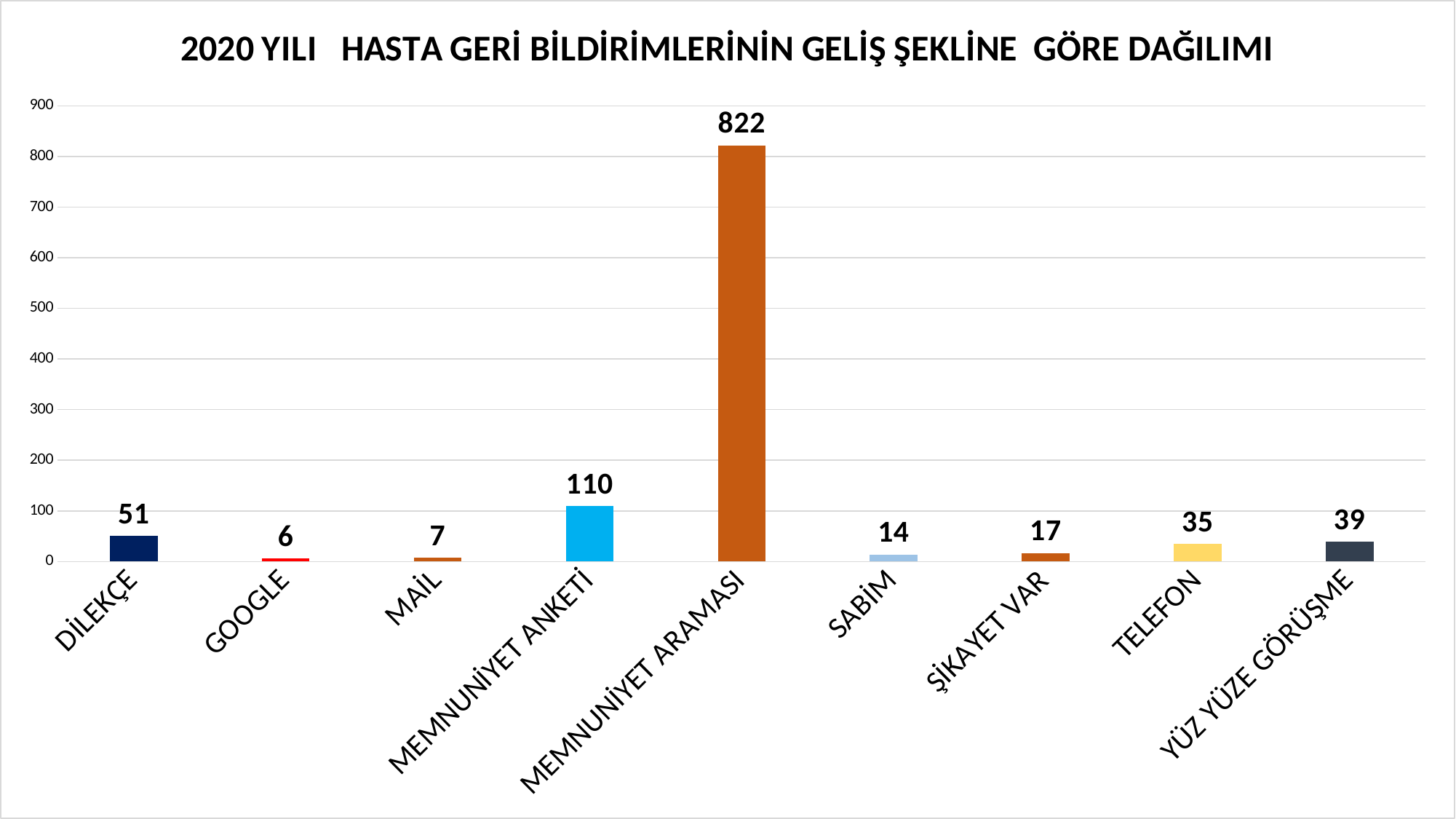
What kind of chart is shown on the slide? bar chart What is the value for SABİM? 14 Which category has the lowest value? GOOGLE What is the difference between the values for MEMNUNİYET ARAMASI and MEMNUNİYET ANKETİ? 712 How many categories are shown on the x axis? 9 What is the value for MEMNUNİYET ARAMASI? 822 Which is larger, the value for DİLEKÇE or the value for ŞİKAYET VAR? DİLEKÇE Which category has the highest value? MEMNUNİYET ARAMASI What is the value for TELEFON? 35 What is the difference between the values for YÜZ YÜZE GÖRÜŞME and TELEFON? 4 Is the value for MEMNUNİYET ANKETİ greater or less than 100? greater What is the value for DİLEKÇE? 51